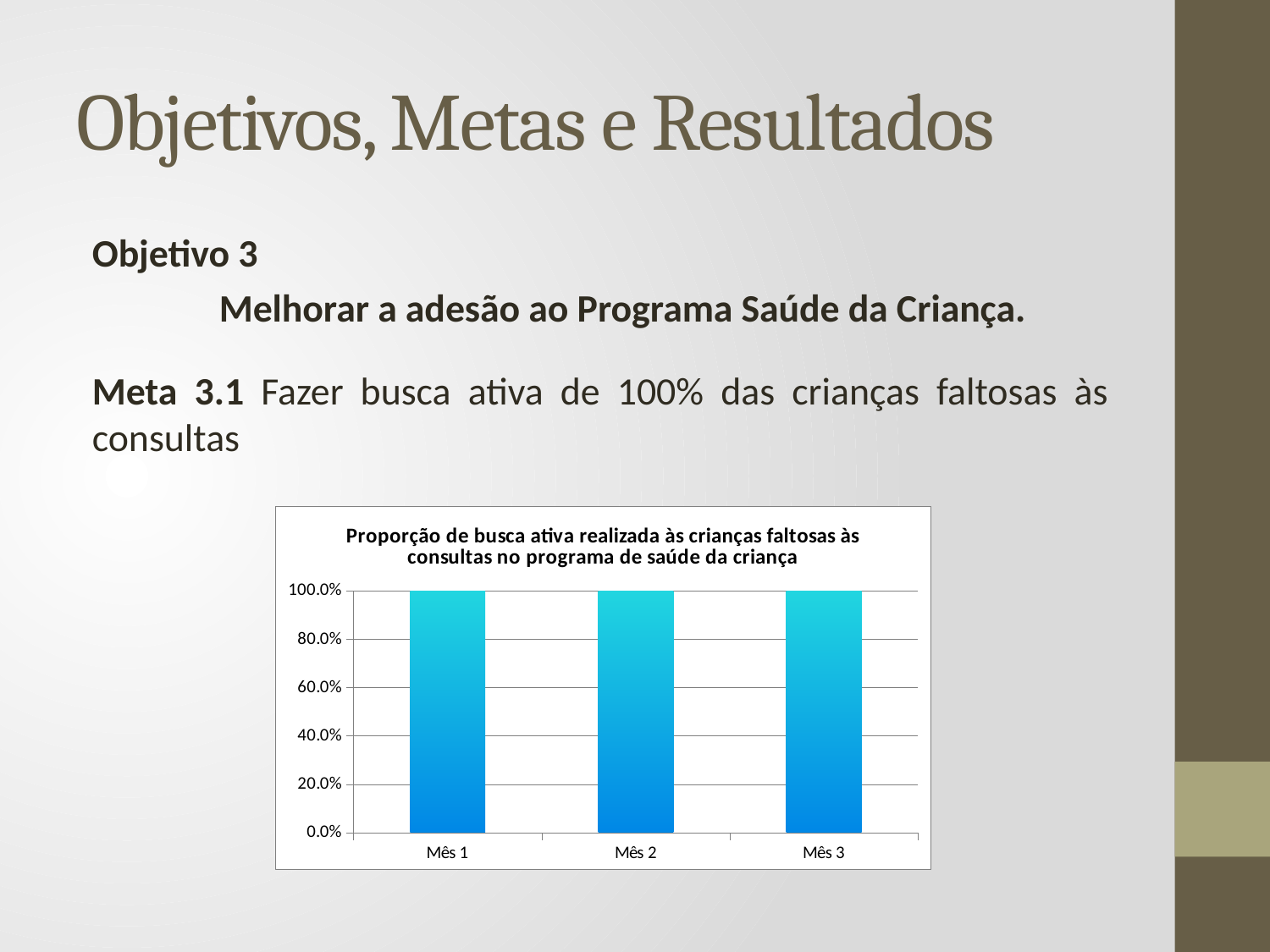
What is the value for Mês 1? 100.0% What is the highest value shown on the y axis of the chart? 100.0% Is the value for Mês 3 greater or less than 60.0%? greater What is the difference between the values for Mês 1 and Mês 2? 0.0% What is the value for Mês 2? 100.0% Is the value for Mês 1 greater or less than 80.0%? greater What is the title of the chart? Proporção de busca ativa realizada às crianças faltosas às consultas no programa de saúde da criança Do the values rise, fall, or stay the same from Mês 1 to Mês 3? stay the same What is the value for Mês 3? 100.0% How many categories are shown on the x axis of the chart? 3 What kind of chart is shown on the slide? bar chart